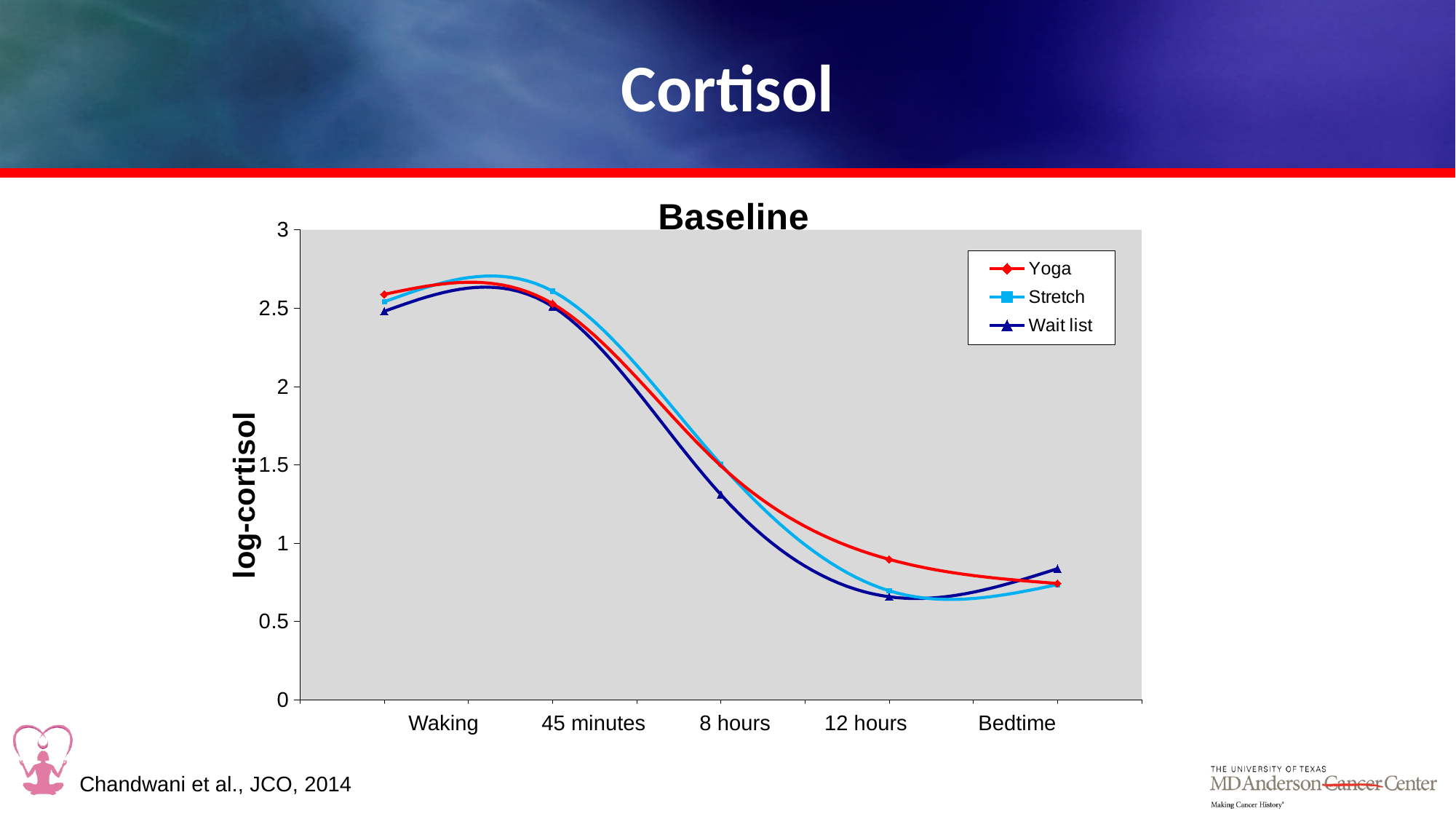
Is the Yoga value at 12 hours greater or less than 1? less What kind of chart is shown on the slide? Line chart At Bedtime, which is larger: the Wait list value or the Stretch value? Wait list Is the Stretch value at Waking greater or less than 2? greater What colour is the Yoga line in the Baseline chart? Red Is the Wait list value at 8 hours greater or less than 1.5? less How many series does the legend of the Baseline chart list? 3 What is the label on the y axis of the Baseline chart? log-cortisol Which series has the highest value at 12 hours? Yoga Does the Yoga line rise or fall from Waking to 12 hours? Fall At 12 hours, which is larger: the Yoga value or the Wait list value? Yoga How many time points are shown on the x axis of the Baseline chart? 5